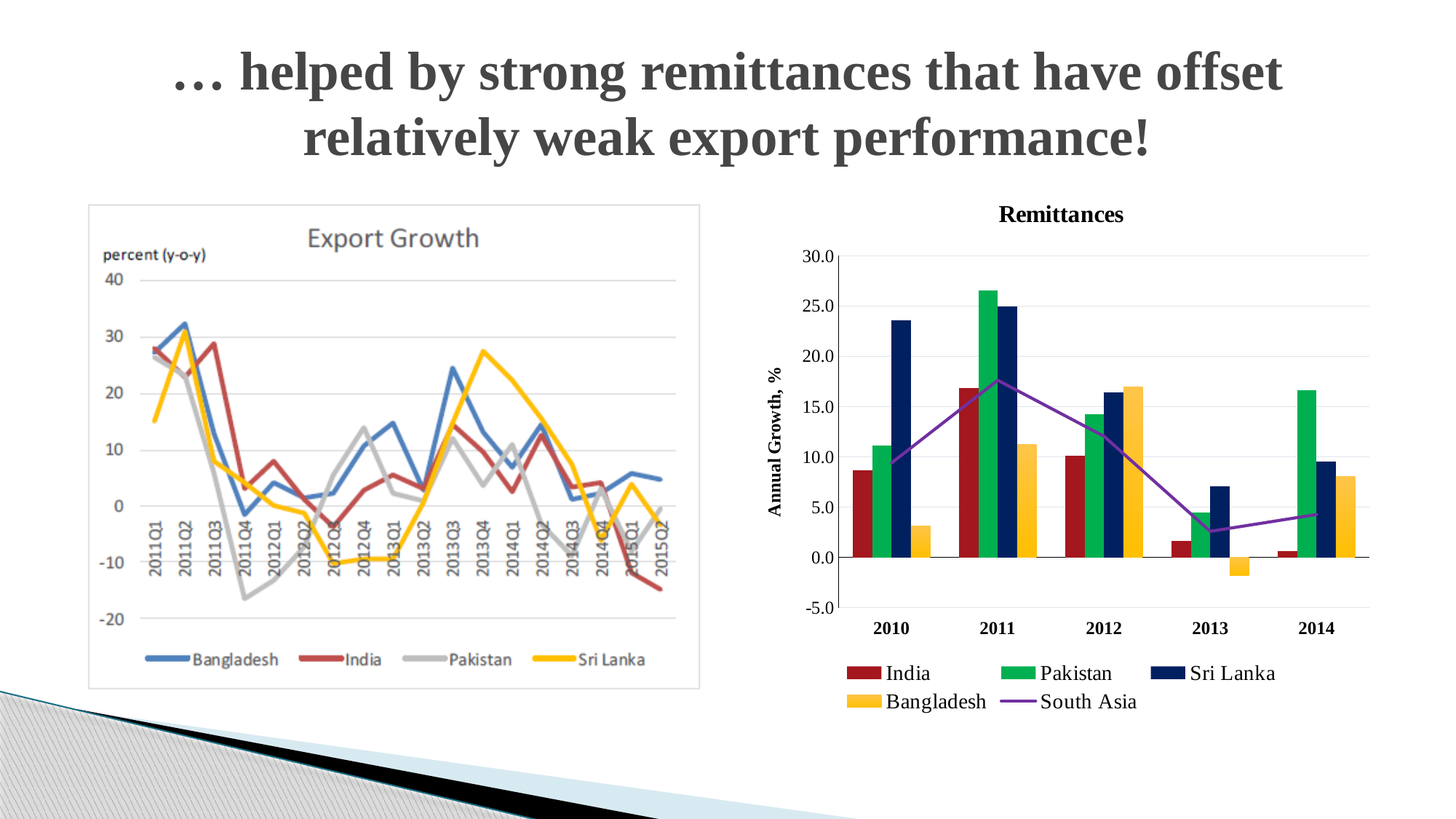
In the Remittances chart, is the value for Sri Lanka in 2010 greater or less than 20.0? greater How many series does the legend of the Export Growth chart list? 4 How many series does the legend of the Remittances chart list? 5 In the Remittances chart, in which year does the South Asia line reach its highest point? 2011 What kind of chart is the Remittances chart on the right? bar chart with a line In the Remittances chart, which is larger in 2012: Bangladesh or India? Bangladesh How many years are shown on the x axis of the Remittances chart? 5 In the Remittances chart, which country has the lowest bar in 2013? Bangladesh In the Export Growth chart, is the value for India in 2015Q2 greater or less than -10? less In the Remittances chart, is the value for India in 2014 greater or less than 5.0? less What kind of chart is the Export Growth chart on the left? line chart In the Remittances chart, which country has the highest bar in 2011? Pakistan